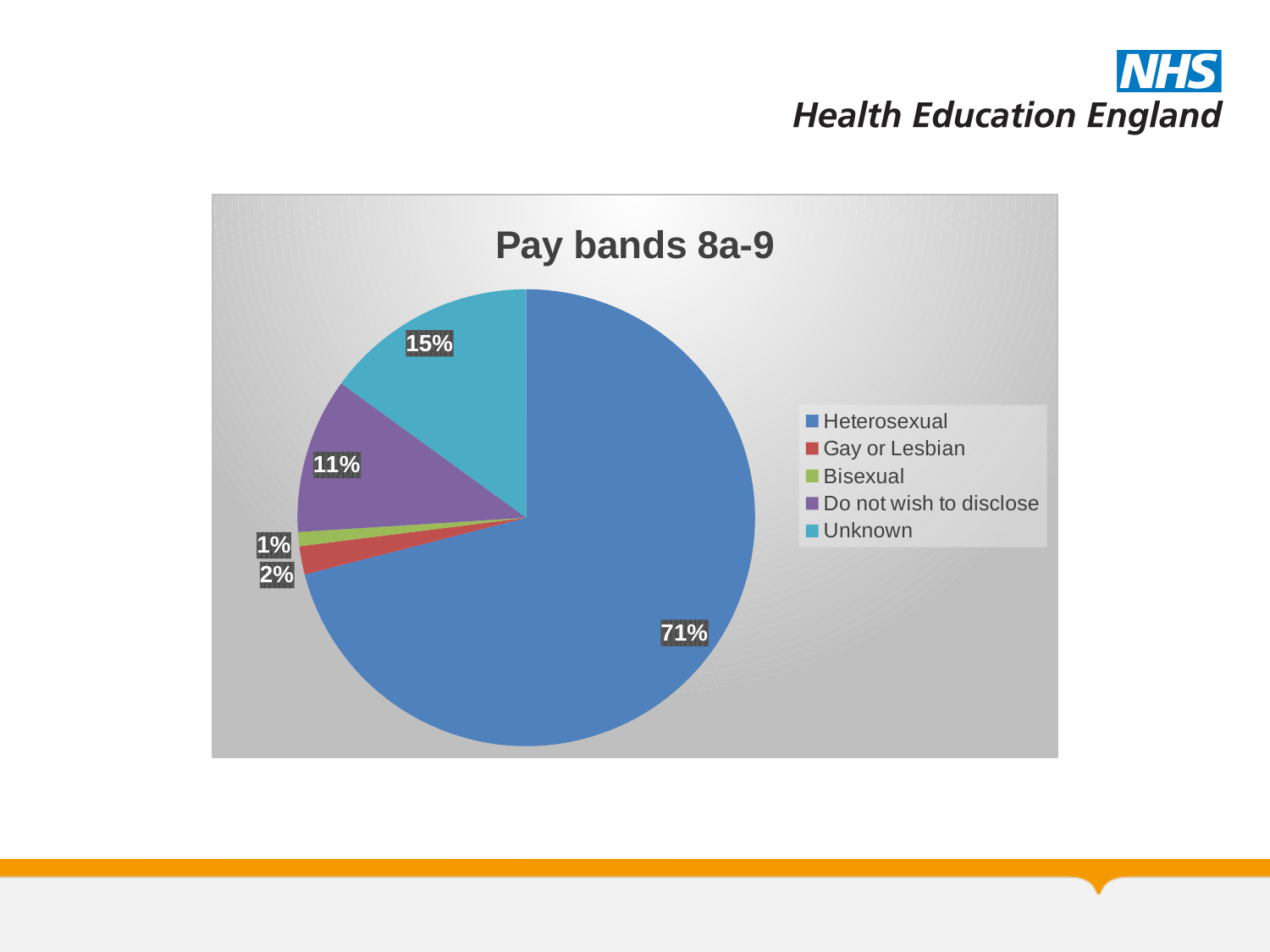
What percentage of the pie is Bisexual? 1% What is the title of the chart? Pay bands 8a-9 What percentage of the pie is Heterosexual? 71% What percentage of the pie is Unknown? 15% What percentage of the pie is Gay or Lesbian? 2% Which category has the largest share of the pie? Heterosexual What percentage of the pie is Do not wish to disclose? 11% What is the difference in percentage points between Unknown and Do not wish to disclose? 4 Which is larger, the share for Unknown or the share for Do not wish to disclose? Unknown How many categories does the legend list? 5 Which category has the smallest share of the pie? Bisexual What type of chart is shown on the slide? Pie chart